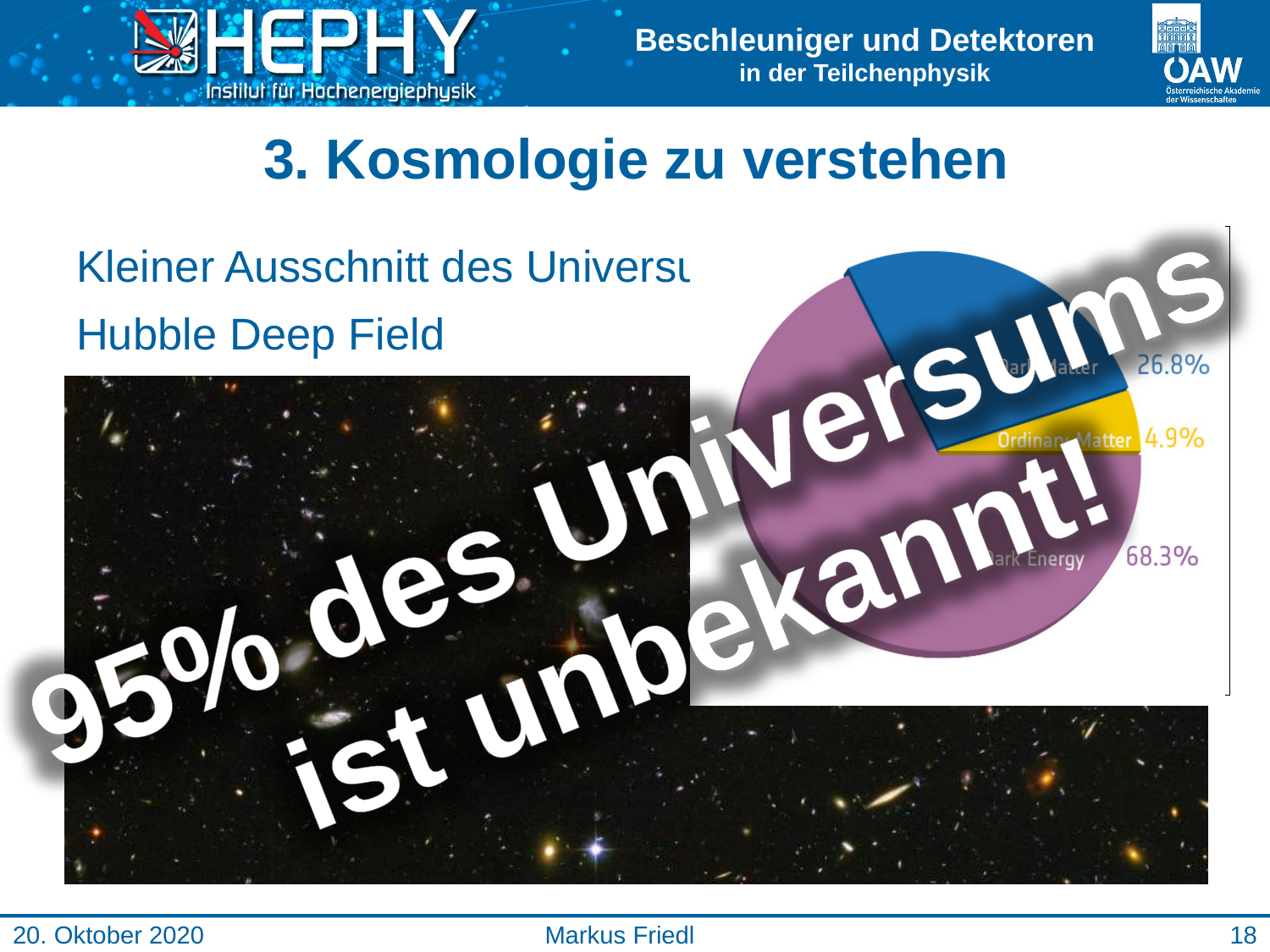
Which slice of the pie chart is the smallest? Ordinary Matter What share of the pie chart is Dark Energy? 68.3% What is the difference between the Dark Energy and Dark Matter shares in the pie chart? 41.5% Which is larger in the pie chart, Dark Matter or Ordinary Matter? Dark Matter What is the combined share of Dark Energy and Dark Matter in the pie chart? 95.1% What colour is the Ordinary Matter slice in the pie chart? yellow How many slices does the pie chart have? 3 What kind of chart is shown on the slide? pie chart Which slice of the pie chart is the largest? Dark Energy What share of the pie chart is Ordinary Matter? 4.9% What is the difference between the Dark Matter and Ordinary Matter shares in the pie chart? 21.9% What share of the pie chart is Dark Matter? 26.8%